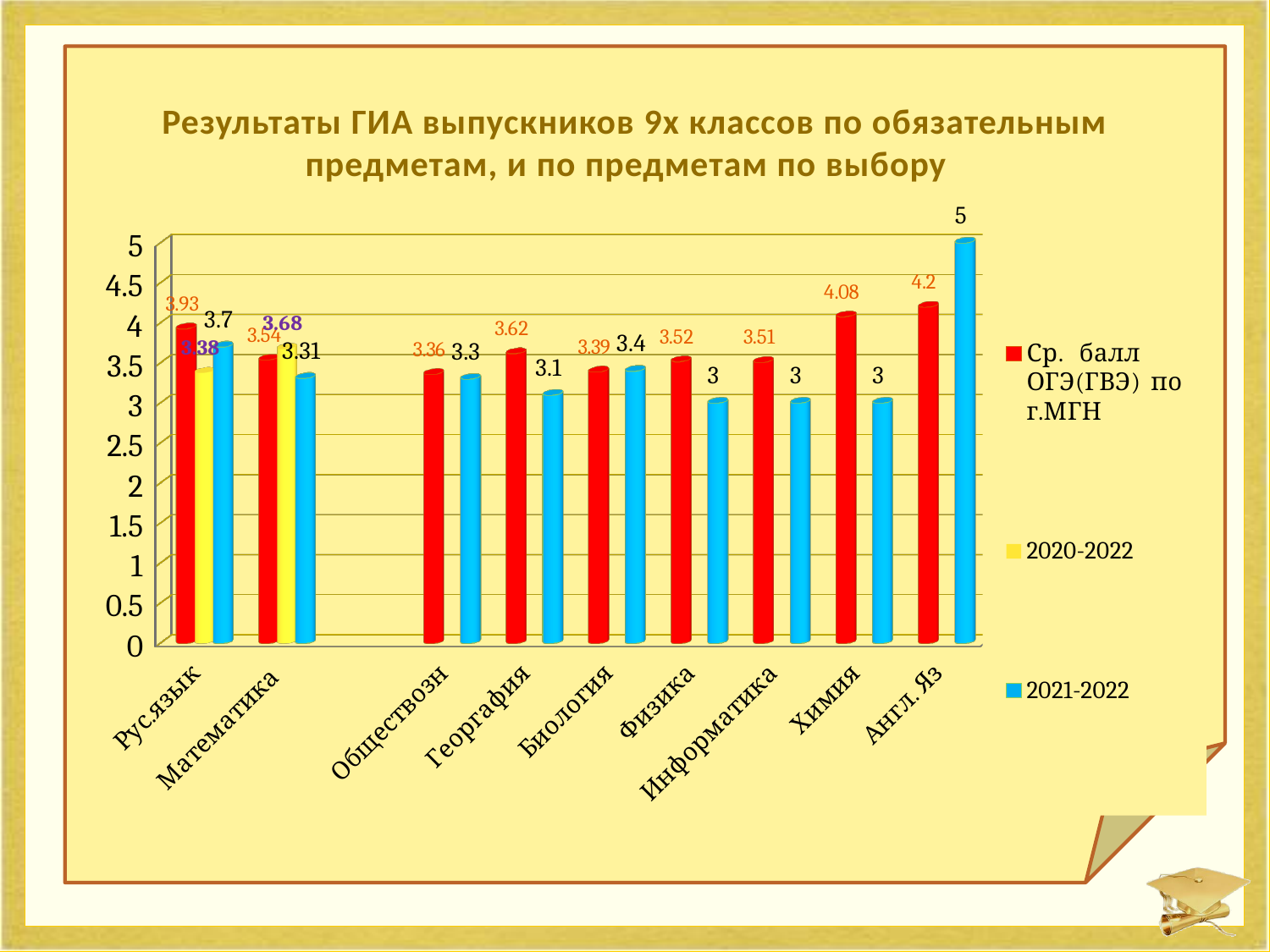
How many series does the legend list? 3 What is the value of 'Ср. балл ОГЭ(ГВЭ) по г.МГН' for Химия? 4.08 What is the 2021-2022 value for Физика? 3 How many subject categories are shown on the x axis? 9 What colour are the bars for the 2021-2022 series? blue What is the 2020-2022 value for Рус.язык? 3.38 For География, which is larger: the 'Ср. балл ОГЭ(ГВЭ) по г.МГН' value or the 2021-2022 value? Ср. балл ОГЭ(ГВЭ) по г.МГН What is the 2021-2022 value for Англ. Яз? 5 What is the difference between the 'Ср. балл ОГЭ(ГВЭ) по г.МГН' value and the 2021-2022 value for Рус.язык? 0.23 What kind of chart is shown on the slide? bar chart Which subject has the highest 'Ср. балл ОГЭ(ГВЭ) по г.МГН' value? Англ. Яз Which subject has the highest 2021-2022 value? Англ. Яз